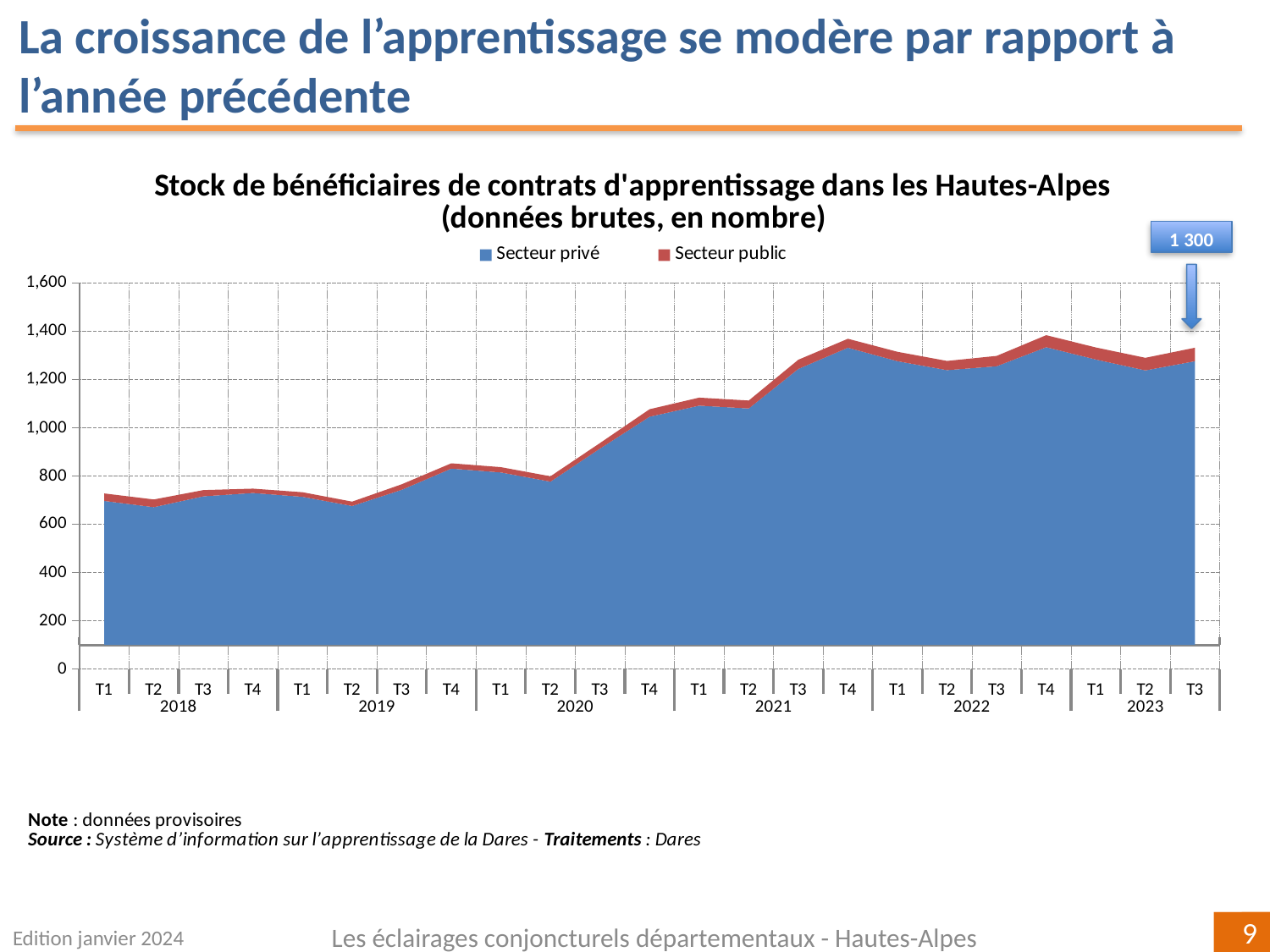
Which is larger, the total for T4 2021 or the total for T1 2018? T4 2021 What value does the callout give for the total stock in T3 2023? 1 300 What are the two series named in the legend? Secteur privé and Secteur public Is the total value for T4 2020 greater or less than 1,000? greater What kind of chart is shown on the slide? Stacked area chart How many quarterly points are plotted along the x axis? 23 Is the total value for T3 2021 greater or less than 1,200? greater Is the total value for T3 2023 greater or less than 1,200? greater Overall, do the total values rise or fall from T1 2018 to T3 2023? rise What is the title of the chart? Stock de bénéficiaires de contrats d'apprentissage dans les Hautes-Alpes (données brutes, en nombre) How many series does the legend list? 2